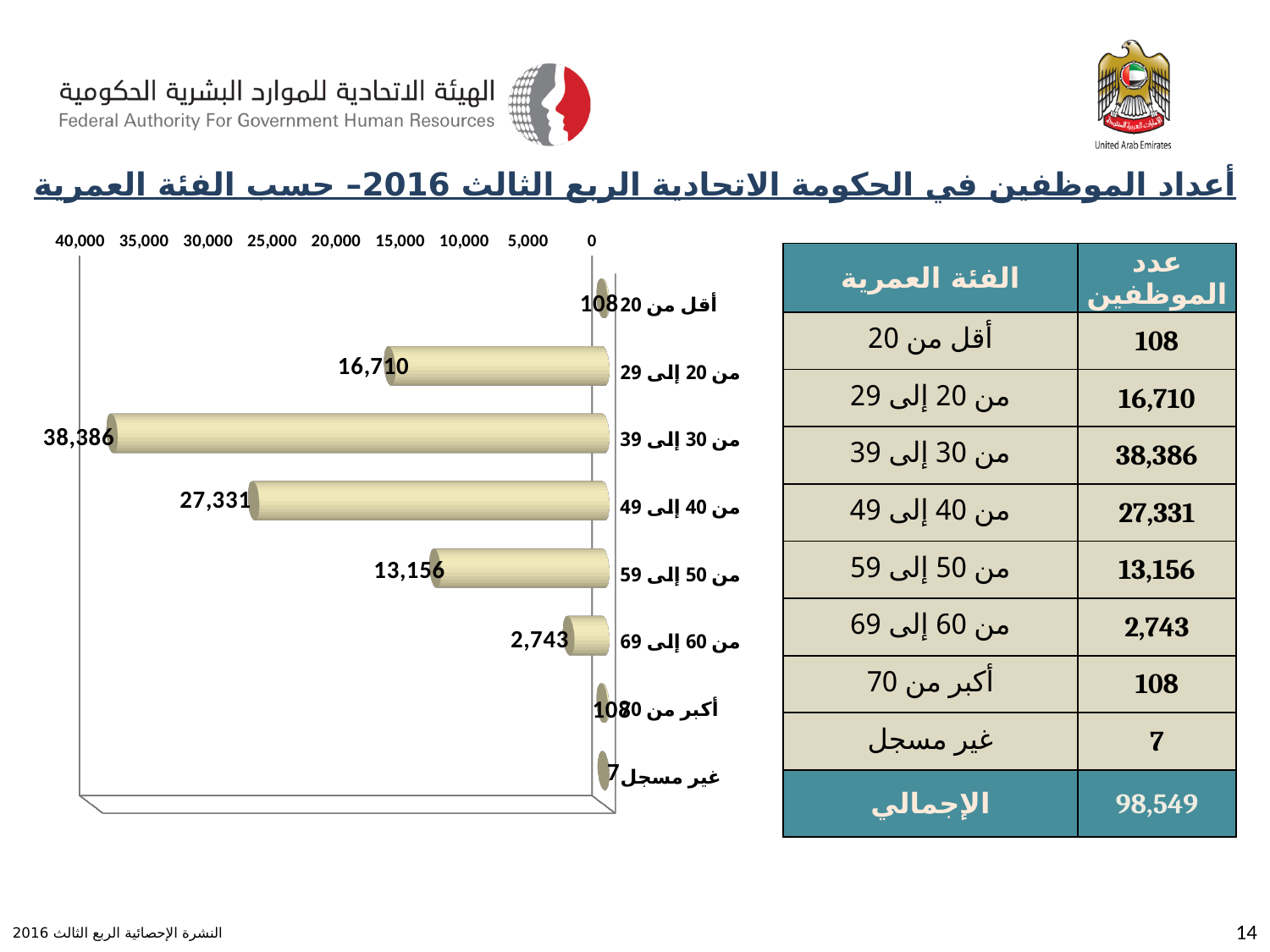
What kind of chart is shown on the slide? bar chart Which age group has the highest number of employees? من 30 إلى 39 What is the value for the category غير مسجل (not registered)? 7 What is the value for the age group من 30 إلى 39 (30 to 39)? 38,386 What is the value for the age group من 60 إلى 69 (60 to 69)? 2,743 How many categories are plotted in the chart? 8 Which category has the lowest value in the chart? غير مسجل Is the value for من 40 إلى 49 greater or less than 25,000? greater What is the value for the age group من 20 إلى 29 (20 to 29)? 16,710 What is the difference between the values for من 30 إلى 39 and من 40 إلى 49? 11,055 Which is larger, the value for من 20 إلى 29 or the value for من 50 إلى 59? من 20 إلى 29 What is the total number of employees shown in the table (الإجمالي)? 98,549